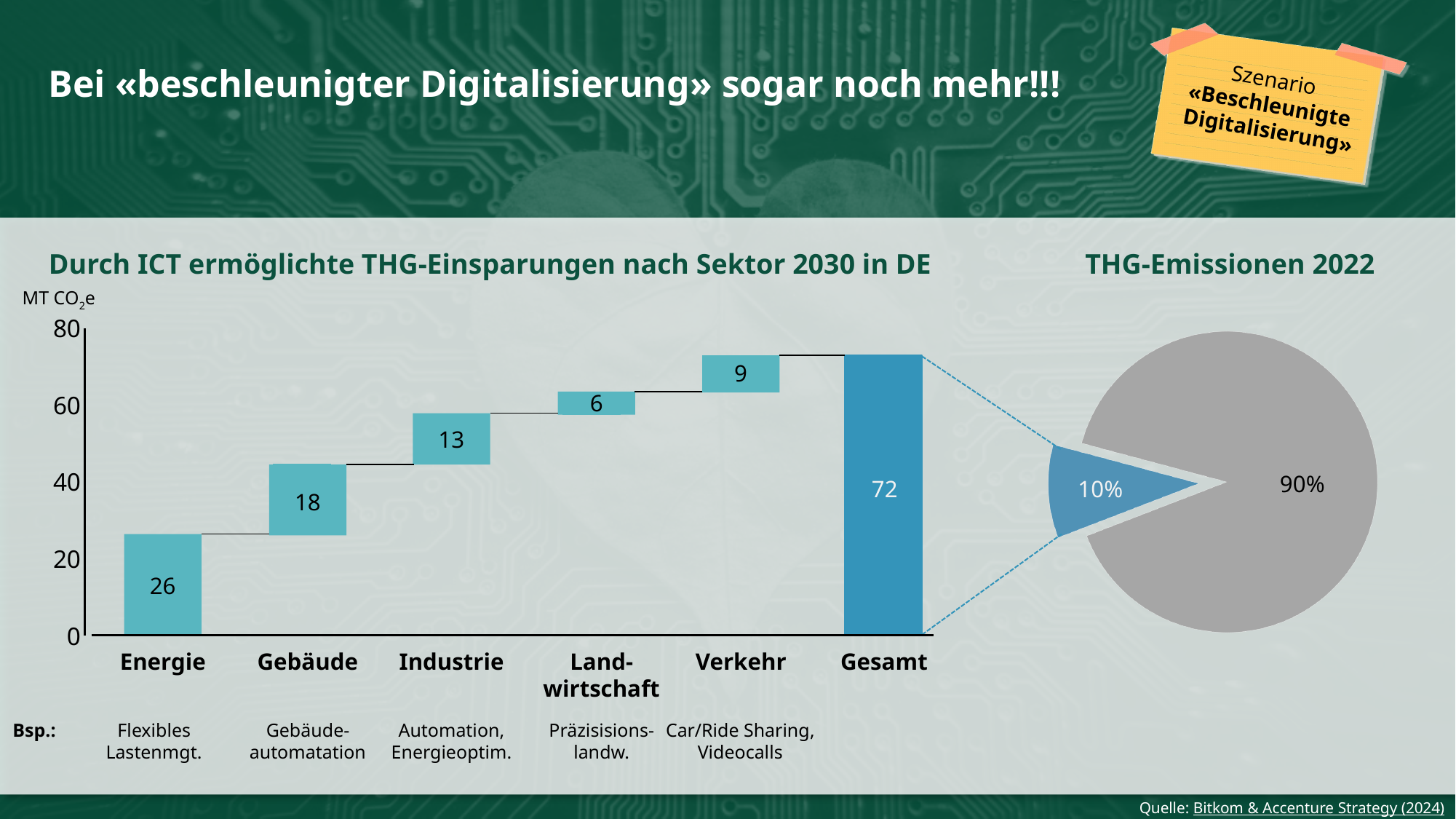
In the chart 'Durch ICT ermöglichte THG-Einsparungen nach Sektor 2030 in DE', what is the value of the Gesamt bar? 72 What kind of chart is 'Durch ICT ermöglichte THG-Einsparungen nach Sektor 2030 in DE'? Bar chart (waterfall) In the chart 'Durch ICT ermöglichte THG-Einsparungen nach Sektor 2030 in DE', how many sectors are shown excluding Gesamt? 5 In the chart 'Durch ICT ermöglichte THG-Einsparungen nach Sektor 2030 in DE', which is larger, the value for Verkehr or the value for Landwirtschaft? Verkehr In the pie chart 'THG-Emissionen 2022', what share does the blue slice represent? 10% In the chart 'Durch ICT ermöglichte THG-Einsparungen nach Sektor 2030 in DE', what is the value for Landwirtschaft? 6 In the chart 'Durch ICT ermöglichte THG-Einsparungen nach Sektor 2030 in DE', which sector has the lowest savings? Landwirtschaft In the chart 'Durch ICT ermöglichte THG-Einsparungen nach Sektor 2030 in DE', what is the value for Energie? 26 What unit is shown on the y axis of the chart 'Durch ICT ermöglichte THG-Einsparungen nach Sektor 2030 in DE'? MT CO2e In the chart 'Durch ICT ermöglichte THG-Einsparungen nach Sektor 2030 in DE', what is the value for Gebäude? 18 In the chart 'Durch ICT ermöglichte THG-Einsparungen nach Sektor 2030 in DE', which sector has the highest savings? Energie In the chart 'Durch ICT ermöglichte THG-Einsparungen nach Sektor 2030 in DE', what is the difference between the values for Energie and Industrie? 13